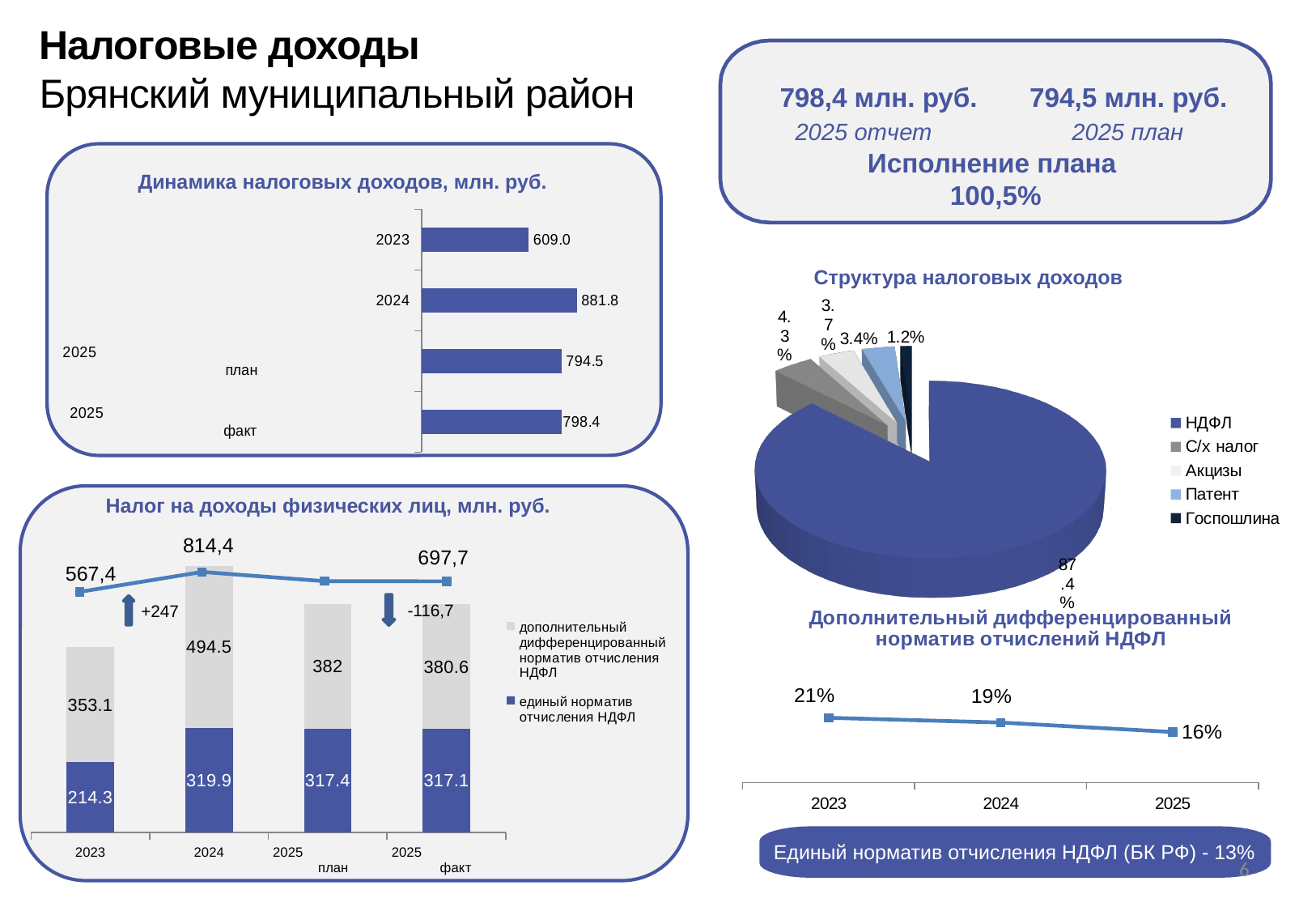
What kind of chart is 'Структура налоговых доходов'? Pie chart In the chart 'Динамика налоговых доходов, млн. руб.', what is the value for 2024? 881.8 In the chart 'Налог на доходы физических лиц, млн. руб.', what is the value of 'единый норматив отчисления НДФЛ' for 2024? 319.9 In the chart 'Динамика налоговых доходов, млн. руб.', what is the difference between the 2024 value and the 2023 value? 272.8 In the chart 'Динамика налоговых доходов, млн. руб.', which year has the lowest value? 2023 In the chart 'Структура налоговых доходов', which category has the smallest share? Госпошлина In the chart 'Дополнительный дифференцированный норматив отчислений НДФЛ', do the values rise or fall from 2023 to 2025? Fall In the chart 'Структура налоговых доходов', what share does НДФЛ have? 87.4% In the chart 'Налог на доходы физических лиц, млн. руб.', how many series does the legend list? 2 In the chart 'Налог на доходы физических лиц, млн. руб.', what is the value of 'дополнительный дифференцированный норматив отчисления НДФЛ' for 2023? 353.1 In the chart 'Динамика налоговых доходов, млн. руб.', which is larger: 2025 план or 2025 факт? 2025 факт In the chart 'Налог на доходы физических лиц, млн. руб.', what is the total of the stacked bar for 2025 план? 699.4